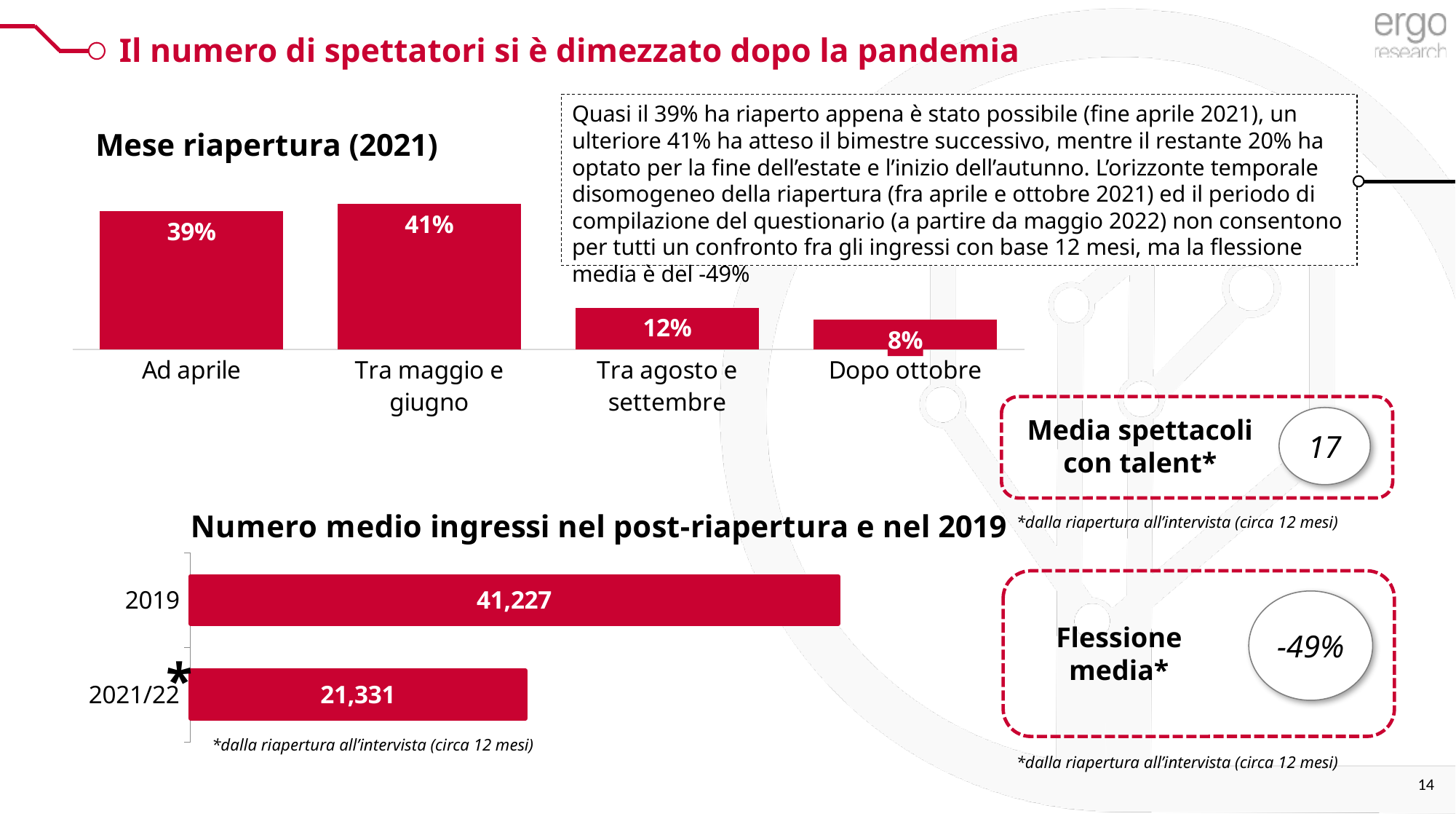
In the 'Numero medio ingressi nel post-riapertura e nel 2019' chart, what is the difference between the 2019 value and the 2021/22 value? 19,896 In the 'Mese riapertura (2021)' chart, what is the value for 'Tra maggio e giugno'? 41% In the 'Numero medio ingressi nel post-riapertura e nel 2019' chart, what is the value for 2019? 41,227 In the 'Mese riapertura (2021)' chart, what is the value for 'Dopo ottobre'? 8% In the 'Mese riapertura (2021)' chart, is the value for 'Tra agosto e settembre' larger or smaller than the value for 'Dopo ottobre'? larger In the 'Numero medio ingressi nel post-riapertura e nel 2019' chart, what is the value for 2021/22? 21,331 In the 'Mese riapertura (2021)' chart, which category has the highest value? Tra maggio e giugno What is the title of the chart at the top left of the slide? Mese riapertura (2021) In the 'Mese riapertura (2021)' chart, which category has the lowest value? Dopo ottobre What kind of chart is the 'Numero medio ingressi nel post-riapertura e nel 2019' chart? Bar chart In the 'Mese riapertura (2021)' chart, what is the difference between 'Ad aprile' and 'Tra agosto e settembre'? 27% In the 'Mese riapertura (2021)' chart, how many categories are shown? 4